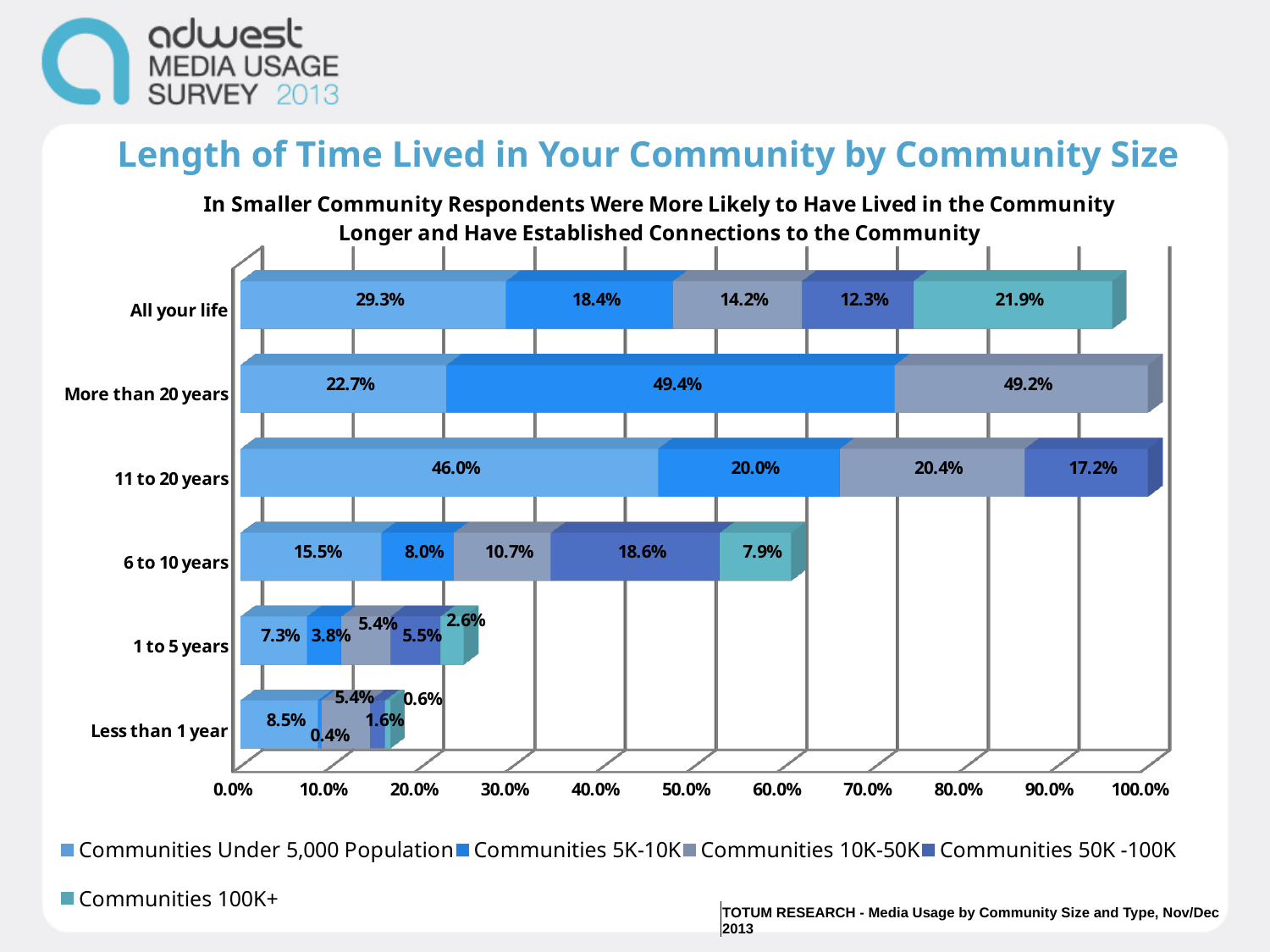
What is the value for Communities 10K-50K in the '11 to 20 years' bar? 20.4% What is the value for Communities 100K+ in the 'All your life' bar? 21.9% What kind of chart is shown on the slide? Stacked bar chart What is the value for Communities 50K -100K in the '6 to 10 years' bar? 18.6% Which category has the highest value for Communities Under 5,000 Population? 11 to 20 years How many length-of-time categories are shown on the chart? 6 In the '1 to 5 years' bar, which is larger: the value for Communities Under 5,000 Population or for Communities 50K -100K? Communities Under 5,000 Population How many series does the legend list? 5 In the 'All your life' bar, what is the difference between the Communities Under 5,000 Population value and the Communities 5K-10K value? 10.9 percentage points What is the value for Communities 5K-10K in the 'More than 20 years' bar? 49.4% What is the total of the stacked 'All your life' bar? 96.1% Which series has the lowest value in the 'Less than 1 year' bar? Communities 5K-10K